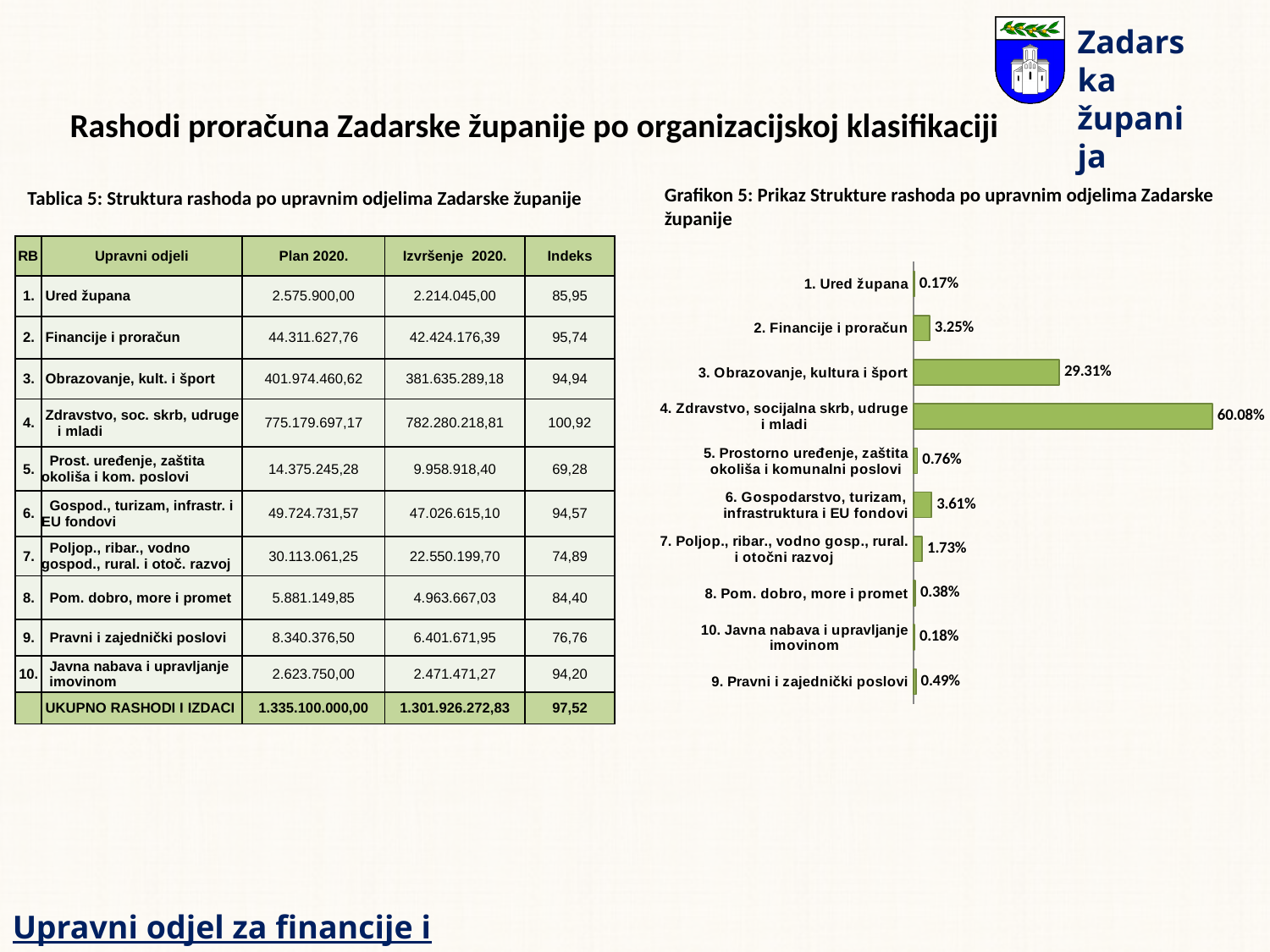
What kind of chart is shown on the slide? Bar chart What is the value shown for "4. Zdravstvo, socijalna skrb, udruge i mladi"? 60.08% Which category has the lowest value in the chart? 1. Ured župana What is the value shown for "3. Obrazovanje, kultura i šport"? 29.31% What is the value shown for "9. Pravni i zajednički poslovi"? 0.49% How many categories are shown in the chart? 10 What is the difference between the values for "4. Zdravstvo, socijalna skrb, udruge i mladi" and "3. Obrazovanje, kultura i šport"? 30.77% What is the difference between the values for "6. Gospodarstvo, turizam, infrastruktura i EU fondovi" and "2. Financije i proračun"? 0.36% Which category has the highest value in the chart? 4. Zdravstvo, socijalna skrb, udruge i mladi What is the title of the chart? Grafikon 5: Prikaz Strukture rashoda po upravnim odjelima Zadarske županije Which has a larger value, "7. Poljop., ribar., vodno gosp., rural. i otočni razvoj" or "8. Pom. dobro, more i promet"? 7. Poljop., ribar., vodno gosp., rural. i otočni razvoj What is the value shown for "6. Gospodarstvo, turizam, infrastruktura i EU fondovi"? 3.61%